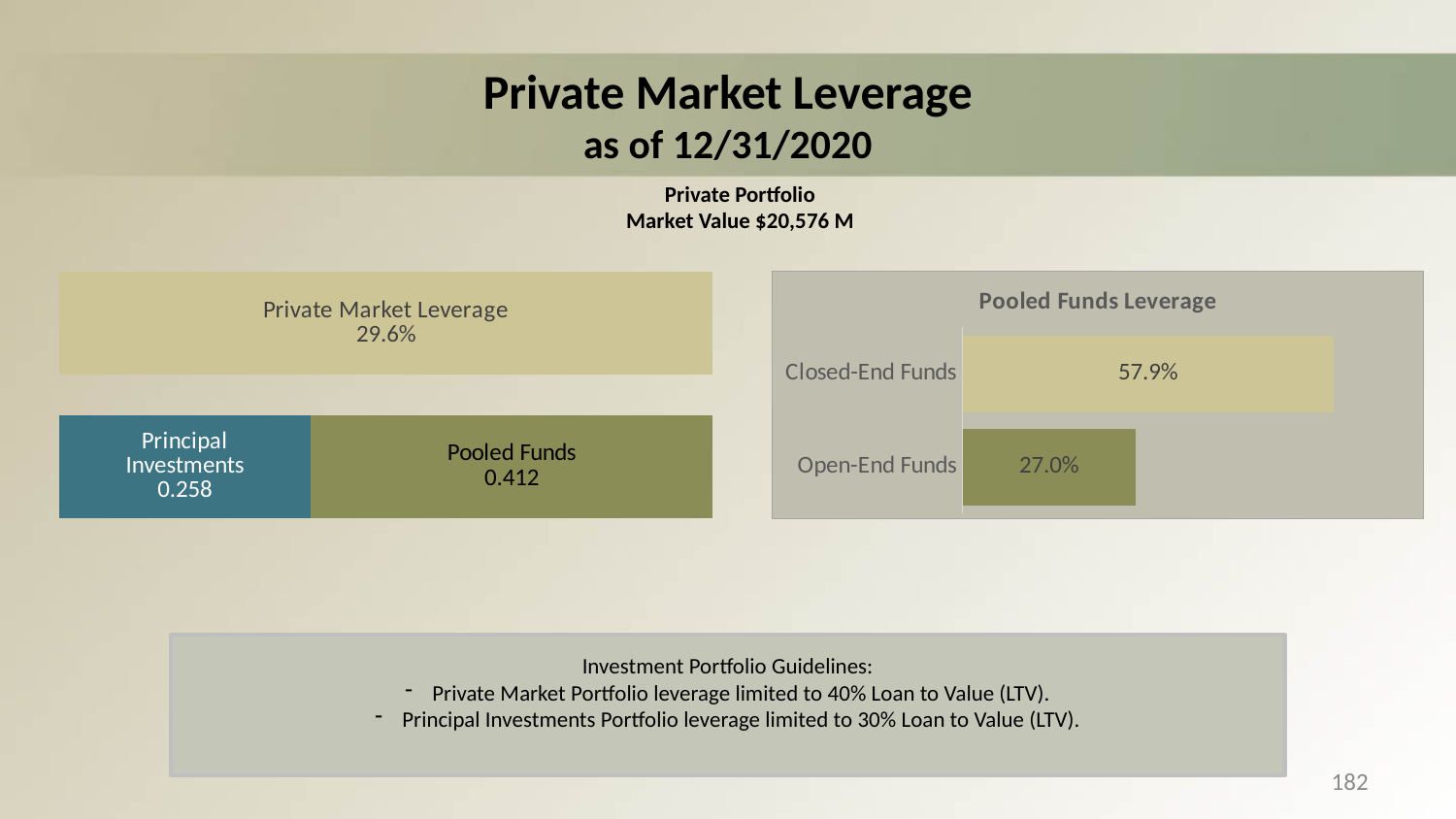
In the Pooled Funds Leverage chart, what is the value for Closed-End Funds? 57.9% In the Pooled Funds Leverage chart, what is the value for Open-End Funds? 27.0% In the Pooled Funds Leverage chart, how many categories are shown? 2 In the left chart, what is the value shown for Principal Investments? 0.258 What kind of chart is the Pooled Funds Leverage chart? Bar chart In the left chart, what is the Private Market Leverage value shown? 29.6% In the Pooled Funds Leverage chart, which category has the lowest value? Open-End Funds In the left chart, what is the value shown for Pooled Funds? 0.412 In the left chart, which is larger, Principal Investments or Pooled Funds? Pooled Funds In the Pooled Funds Leverage chart, which category has the highest value? Closed-End Funds In the Pooled Funds Leverage chart, what is the difference between Closed-End Funds and Open-End Funds? 30.9% What is the title of the chart on the right side of the slide? Pooled Funds Leverage